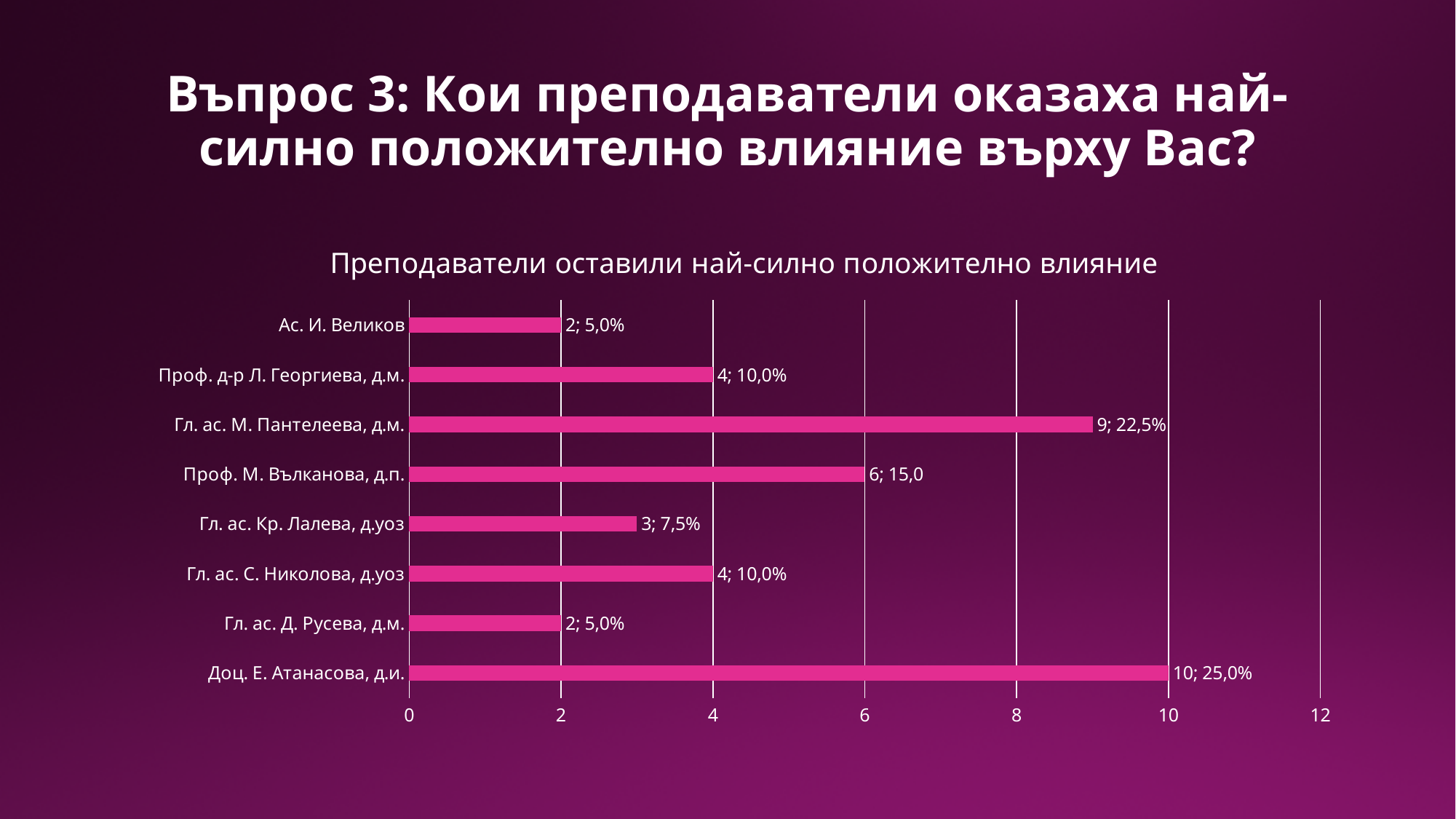
What is the highest value shown on the x axis? 12 Which category has the highest value? Доц. Е. Атанасова, д.и. Which is larger, the value for Проф. д-р Л. Георгиева, д.м. or the value for Проф. М. Вълканова, д.п.? Проф. М. Вълканова, д.п. What is the difference between the values for Гл. ас. С. Николова, д.уоз and Гл. ас. Д. Русева, д.м.? 2 What kind of chart is shown on the slide? bar chart Is the value for Гл. ас. М. Пантелеева, д.м. greater or less than 8? greater What is the difference between the values for Доц. Е. Атанасова, д.и. and Гл. ас. М. Пантелеева, д.м.? 1 What is the value for Проф. М. Вълканова, д.п.? 6; 15,0 How many categories are shown in the chart? 8 What is the title of the chart? Преподаватели оставили най-силно положително влияние What is the value for Гл. ас. Кр. Лалева, д.уоз? 3; 7,5% What is the value for Гл. ас. М. Пантелеева, д.м.? 9; 22,5%